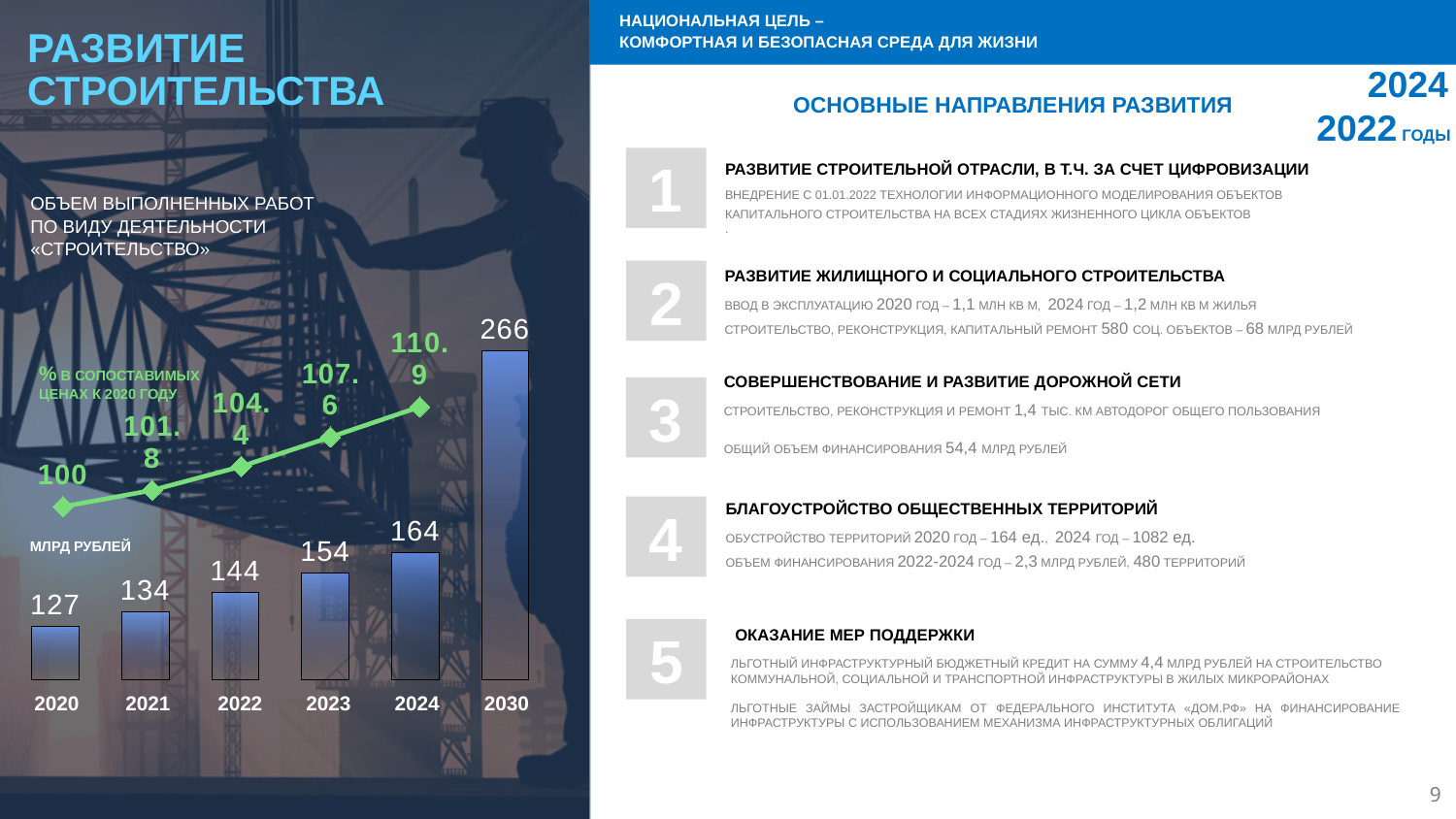
How many years are shown on the x axis of the chart? 6 Which year has the lowest bar value in the chart? 2020 What is the value of the line (% в сопоставимых ценах к 2020 году) for 2024? 110.9 What is the value of the line (% в сопоставимых ценах к 2020 году) for 2023? 107.6 What is the difference between the bar values for 2030 and 2024? 102 What is the difference between the bar values for 2022 and 2021? 10 What is the value of the bar for 2030 in the chart? 266 Which is larger, the bar value for 2023 or for 2021? 2023 Which year has the highest bar value in the chart? 2030 Do the bar values rise or fall from 2020 to 2030? rise What is the value of the bar for 2024 in the chart "Объем выполненных работ по виду деятельности «Строительство»"? 164 What is the value of the bar for 2020 in the chart? 127